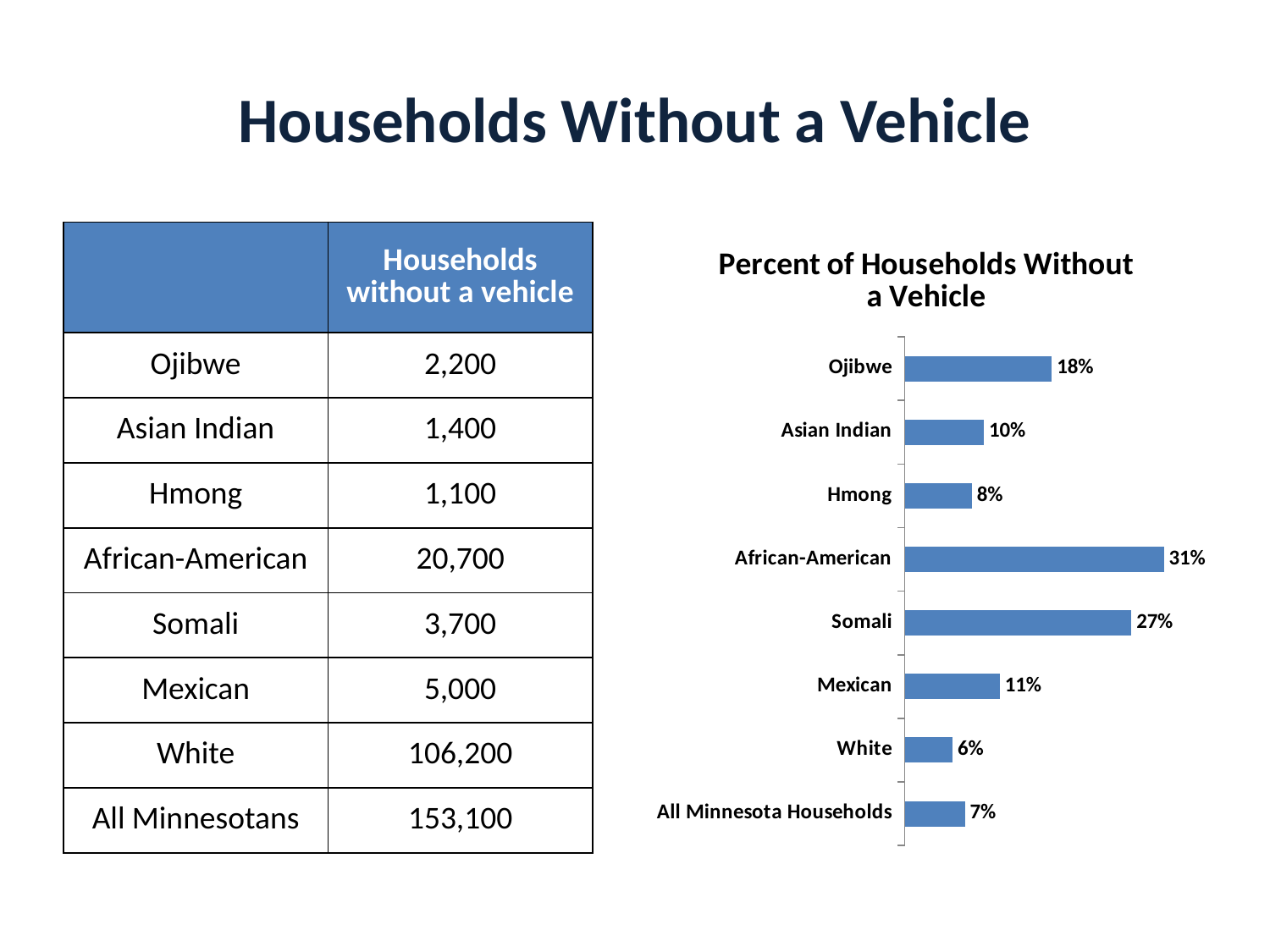
What is the difference in percentage points between Somali and Ojibwe households without a vehicle? 9 How many categories are shown in the chart? 8 Which category has the highest percent of households without a vehicle? African-American Which category has the lowest percent of households without a vehicle? White What kind of chart is shown on the slide? Bar chart What is the percent of households without a vehicle for All Minnesota Households? 7% What is the difference in percentage points between African-American and White households without a vehicle? 25 Which has a higher percent of households without a vehicle, Mexican or Asian Indian? Mexican What is the percent of households without a vehicle for Hmong households? 8% What is the title of the chart? Percent of Households Without a Vehicle What is the percent of households without a vehicle for African-American households? 31% Which has a higher percent of households without a vehicle, Somali or Ojibwe? Somali